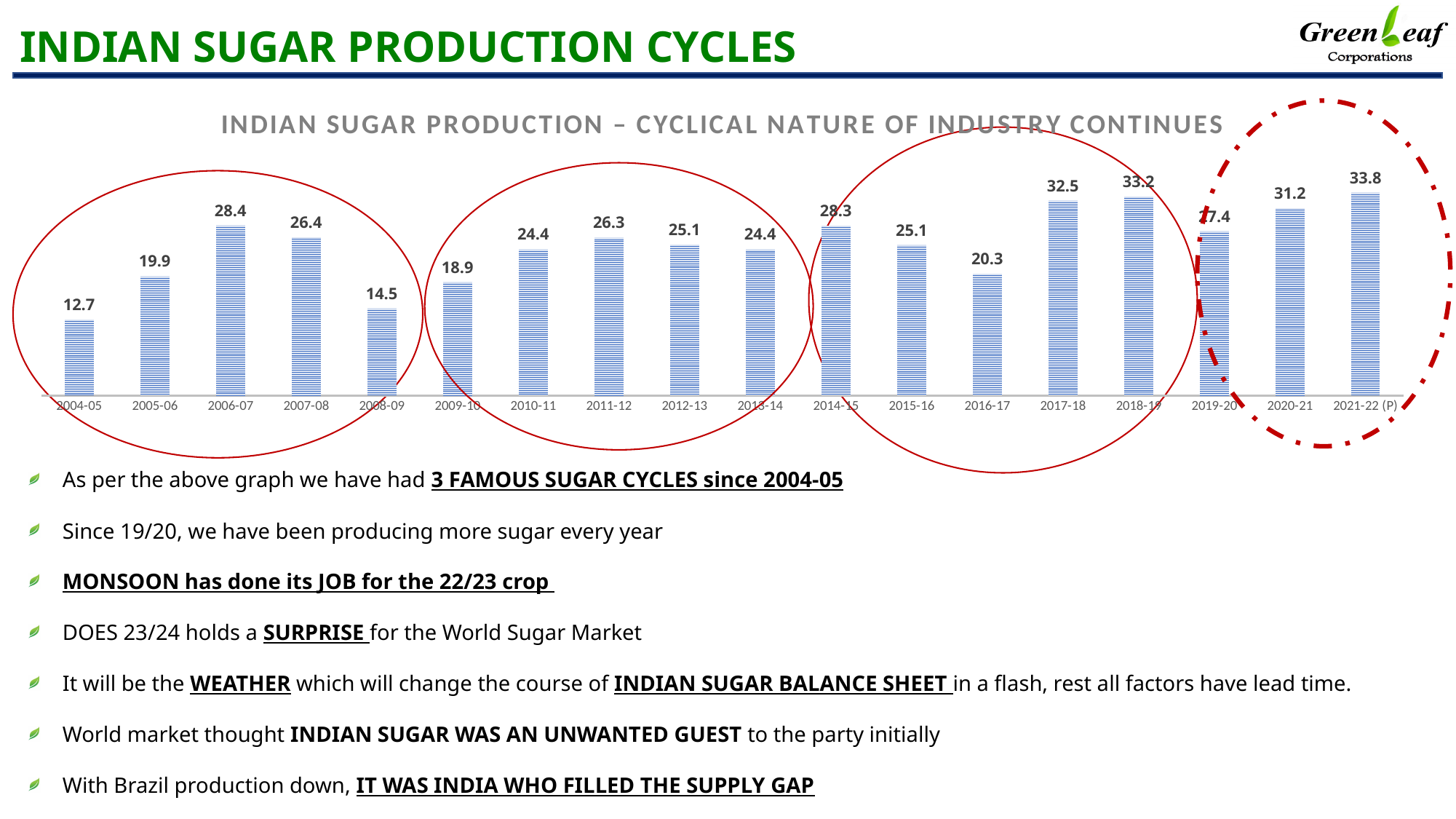
How many years (categories) are shown on the chart? 18 What is the value shown for 2004-05? 12.7 What is the difference between the values for 2018-19 and 2019-20? 5.8 What is the value shown for 2017-18? 32.5 What is the difference between the values for 2006-07 and 2008-09? 13.9 What type of chart is shown on the slide? Bar chart What is the value shown for 2021-22 (P)? 33.8 Which is larger, the value for 2014-15 or the value for 2015-16? 2014-15 What is the title of the chart? INDIAN SUGAR PRODUCTION – CYCLICAL NATURE OF INDUSTRY CONTINUES Which year has the lowest value on the chart? 2004-05 Which year has the highest value on the chart? 2021-22 (P) What is the value shown for 2016-17? 20.3